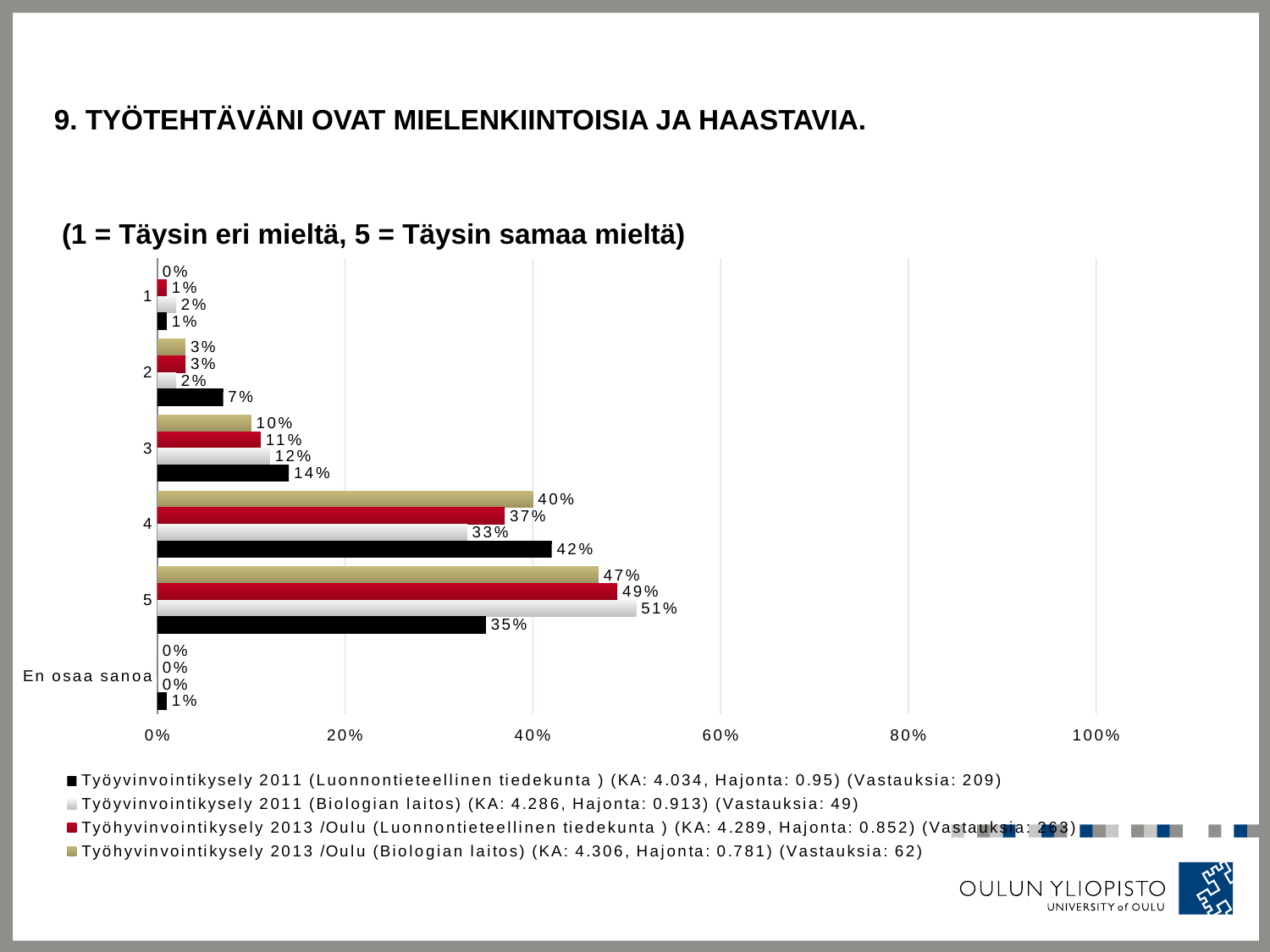
What is the value for category 3 in the Työhyvinvointikysely 2013 /Oulu (Biologian laitos) series? 10% What kind of chart is shown on the slide? bar chart What is the difference between the Työyvinvointikysely 2011 (Biologian laitos) value and the Työyvinvointikysely 2011 (Luonnontieteellinen tiedekunta) value for category 5? 16% For category 4, which is larger: the Työhyvinvointikysely 2013 /Oulu (Biologian laitos) value or the Työhyvinvointikysely 2013 /Oulu (Luonnontieteellinen tiedekunta) value? Työhyvinvointikysely 2013 /Oulu (Biologian laitos) How many categories are shown on the vertical axis? 6 What is the value for En osaa sanoa in the Työyvinvointikysely 2011 (Luonnontieteellinen tiedekunta) series? 1% What is the value for category 4 in the Työyvinvointikysely 2011 (Luonnontieteellinen tiedekunta) series? 42% How many series does the legend list? 4 What is the value for category 5 in the Työyvinvointikysely 2011 (Biologian laitos) series? 51% Which category has the highest value in the Työyvinvointikysely 2011 (Luonnontieteellinen tiedekunta) series? 4 Is the value for category 5 in the Työhyvinvointikysely 2013 /Oulu (Luonnontieteellinen tiedekunta) series greater or less than 40%? greater Which category has the highest value in the Työhyvinvointikysely 2013 /Oulu (Luonnontieteellinen tiedekunta) series? 5